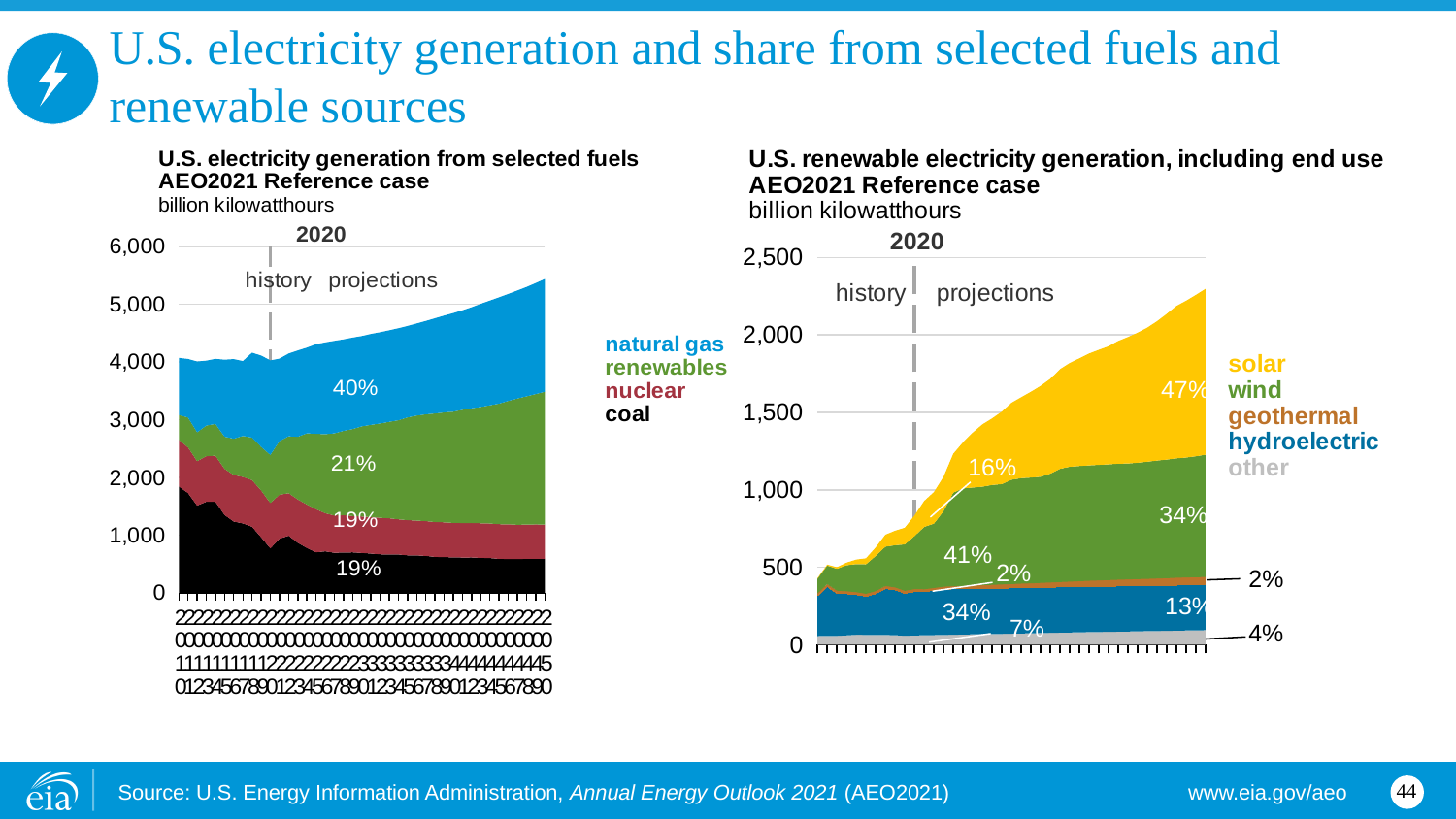
In the right chart, 'U.S. renewable electricity generation, including end use', what share is labeled for solar at the end of the projection period? 47% In the left chart, 'U.S. electricity generation from selected fuels', is total generation at the end of the projection period greater or less than 5,000 billion kilowatthours? greater How many series does the legend of the left chart, 'U.S. electricity generation from selected fuels', list? 4 How many series does the legend of the right chart, 'U.S. renewable electricity generation, including end use', list? 5 In the left chart, 'U.S. electricity generation from selected fuels', what is the difference between the labeled natural gas share (40%) and the labeled renewables share (21%)? 19 percentage points In the right chart, 'U.S. renewable electricity generation, including end use', what share is labeled for hydroelectric at the end of the projection period? 13% In the right chart, 'U.S. renewable electricity generation, including end use', what share is labeled for wind at the end of the projection period? 34% What kind of chart is the left chart, 'U.S. electricity generation from selected fuels'? stacked area chart In the right chart, 'U.S. renewable electricity generation, including end use', is total renewable generation at the end of the projection period greater or less than 2,000 billion kilowatthours? greater